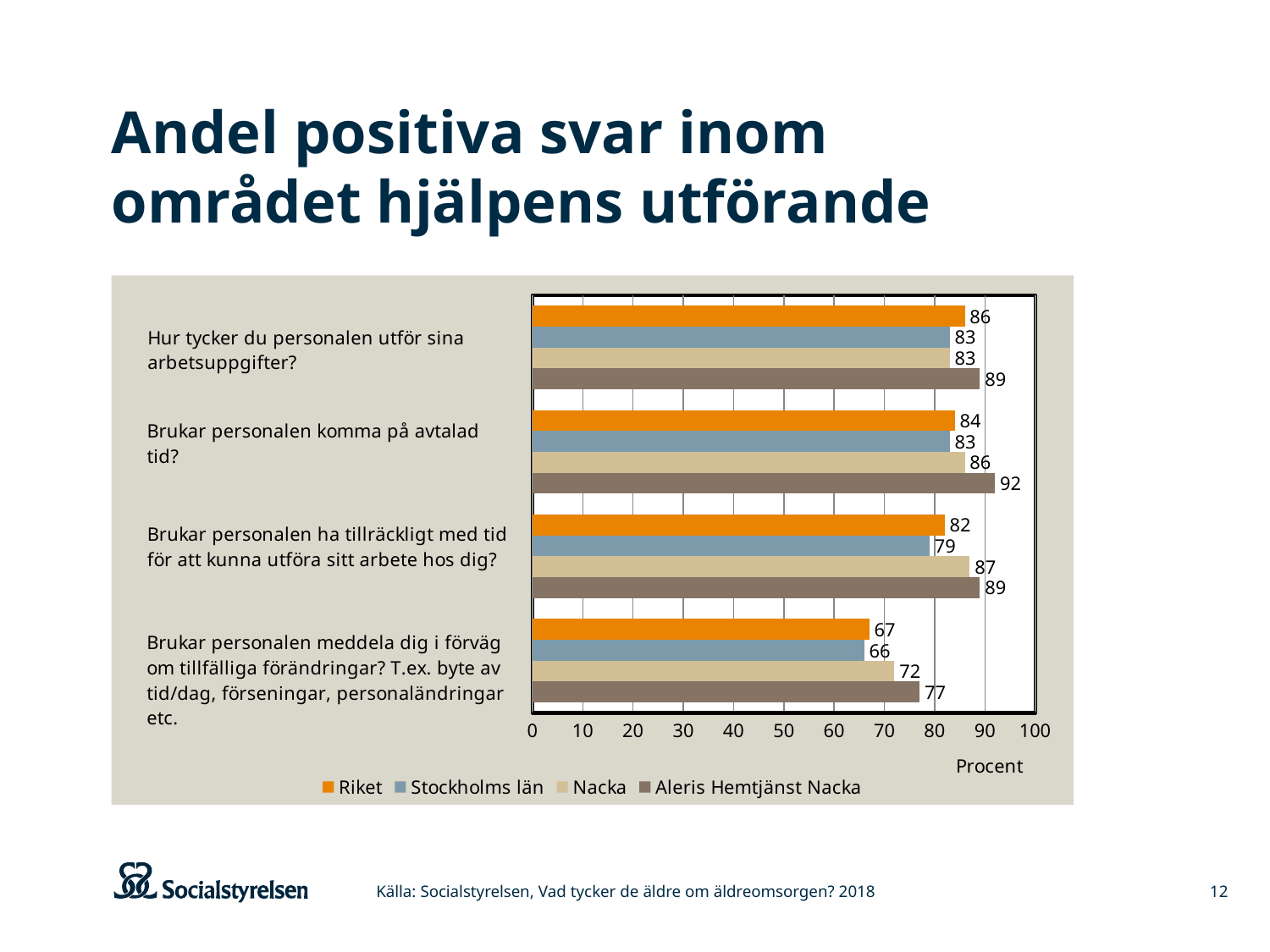
How many question categories are shown on the chart? 4 What kind of chart is shown on the slide? Bar chart Which is larger on "Brukar personalen ha tillräckligt med tid för att kunna utföra sitt arbete hos dig?": Nacka or Riket? Nacka What is the value for Riket on "Hur tycker du personalen utför sina arbetsuppgifter?" 86 Which series has the highest value on "Brukar personalen komma på avtalad tid?" Aleris Hemtjänst Nacka What is the difference between Aleris Hemtjänst Nacka and Riket on "Brukar personalen meddela dig i förväg om tillfälliga förändringar?" 10 How many series does the legend list? 4 What is the value for Nacka on "Brukar personalen meddela dig i förväg om tillfälliga förändringar?" 72 What is the label on the horizontal axis of the chart? Procent Which series has the lowest value on "Brukar personalen meddela dig i förväg om tillfälliga förändringar?" Stockholms län What is the value for Stockholms län on "Brukar personalen ha tillräckligt med tid för att kunna utföra sitt arbete hos dig?" 79 What is the value for Aleris Hemtjänst Nacka on "Brukar personalen komma på avtalad tid?" 92